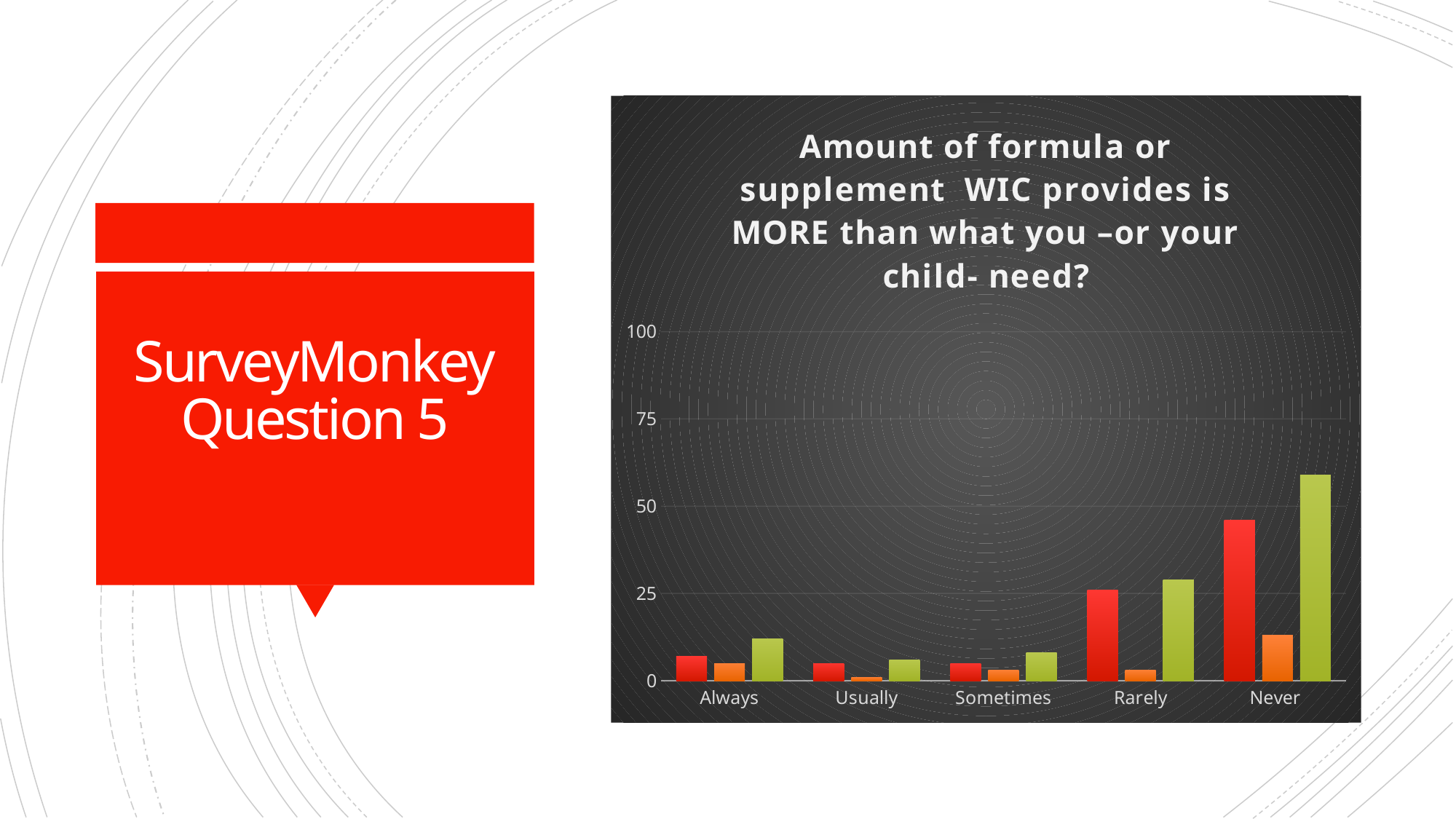
Is the value of the orange bar for Never greater or less than 25? less How many categories are shown on the x axis of the chart? 5 Is the value of the red bar for Never greater or less than 50? less How many bars are plotted for each category in the chart? 3 Do the bar values generally rise or fall moving from Always to Never along the x axis? rise Is the value of the green bar for Never greater or less than 50? greater What kind of chart is shown on the slide? bar chart Which category has the tallest bar in the chart? Never Which is larger: the red bar for Always or the red bar for Never? the red bar for Never What is the title of the chart? Amount of formula or supplement WIC provides is MORE than what you –or your child- need? Which is larger for the Never category: the red bar or the green bar? the green bar